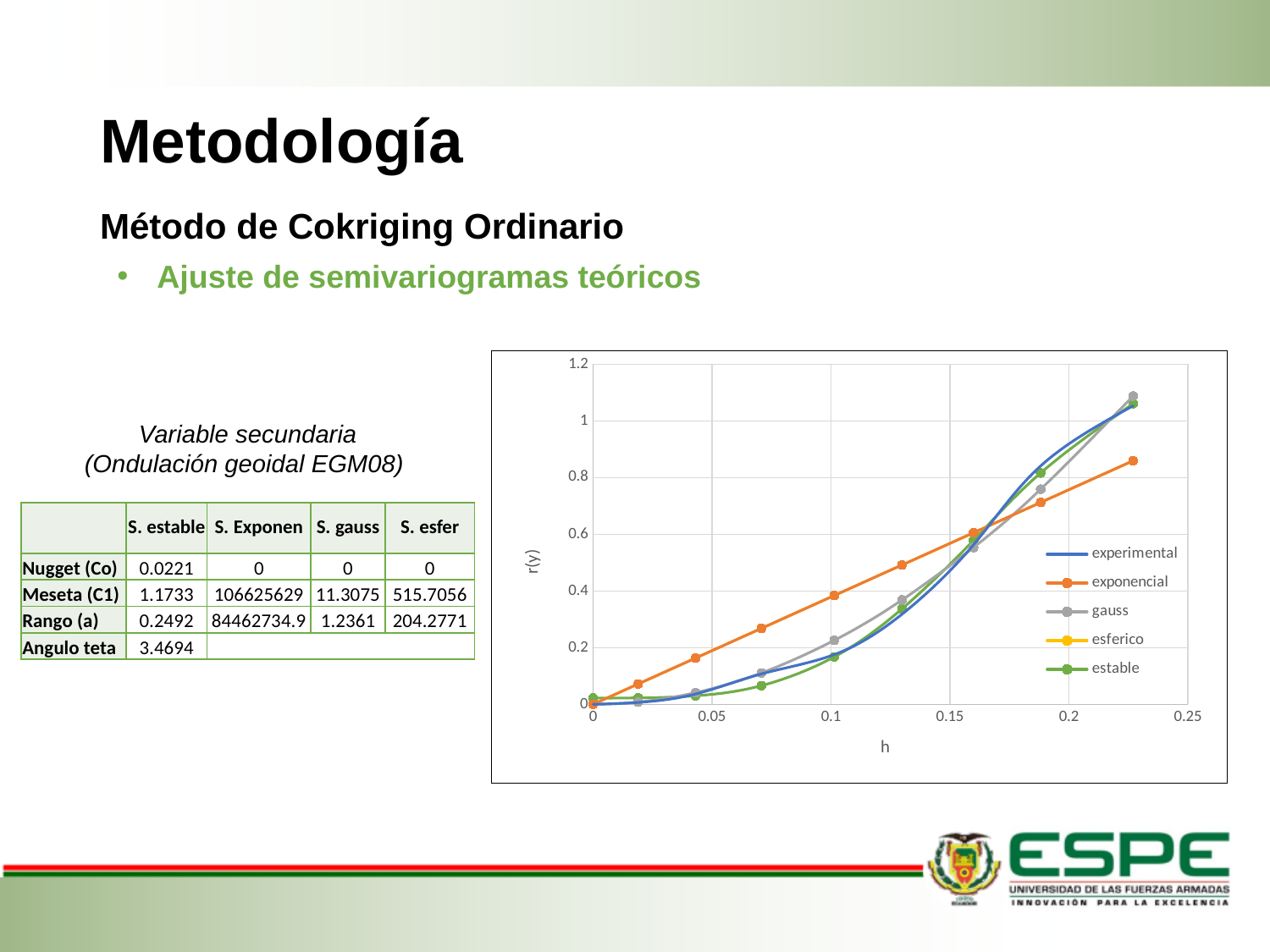
At h = 0.1, which series has the larger value, exponencial or estable? exponencial Is the value of the gauss series at its rightmost point greater or less than 1? greater How many series does the chart legend list? 5 Is the value of the estable series at h = 0.07 greater or less than 0.2? less What is the label of the x axis of the chart? h Is the value of the exponencial series at its rightmost point greater or less than 1? less Do the values of the experimental series rise or fall as h increases? rise At the rightmost point of the chart, which series has the larger value, gauss or exponencial? gauss What are the series names listed in the chart legend? experimental, exponencial, gauss, esferico, estable What kind of chart is shown on the slide? line chart